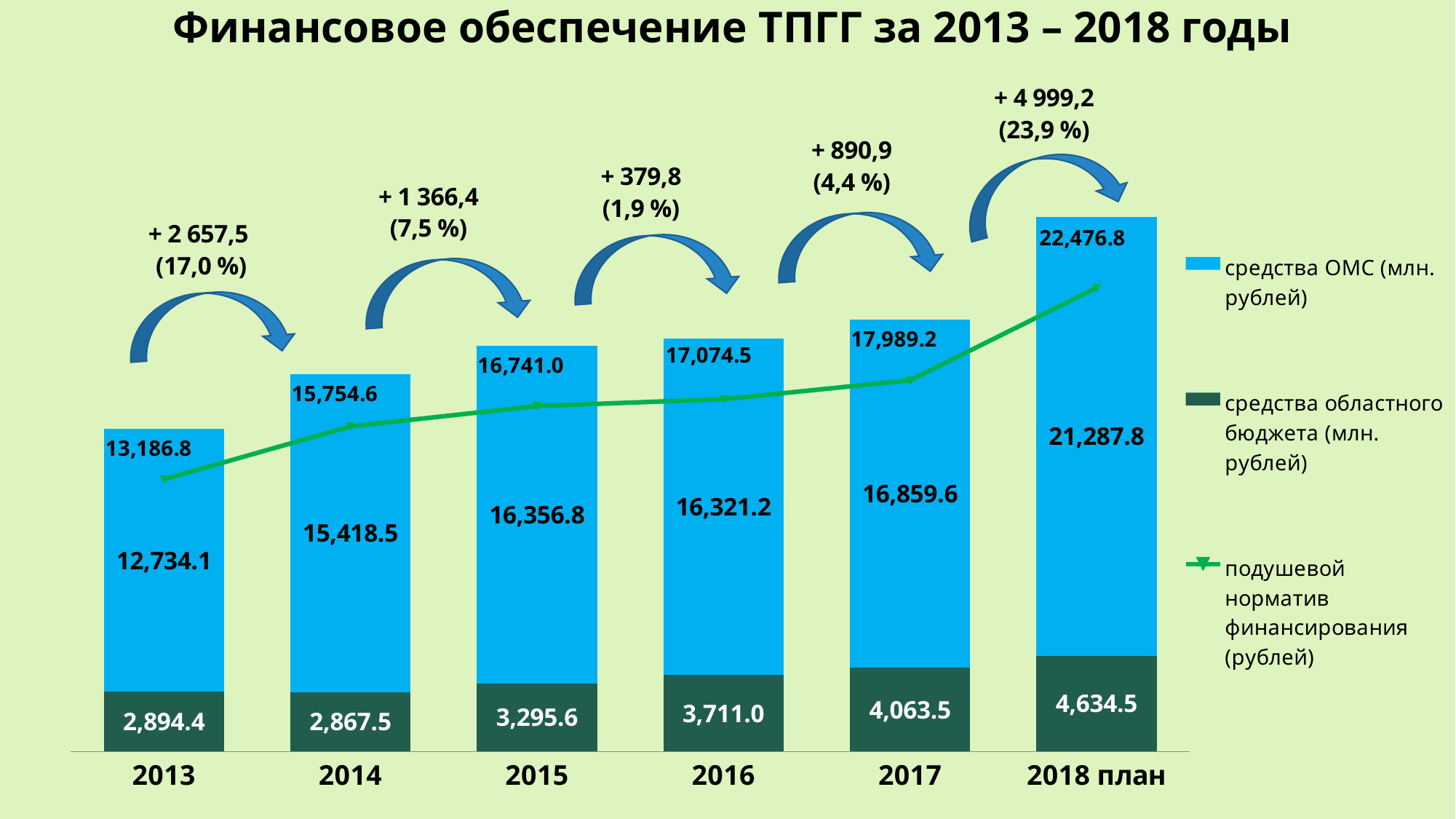
Does подушевой норматив финансирования (рублей) rise or fall from 2013 to 2018 план? Rise Which is larger: средства ОМС (млн. рублей) in 2015 or in 2016? 2015 What is the total of the stacked bar for 2013 (средства ОМС plus средства областного бюджета)? 15,628.5 How many years are shown on the x axis? 6 What is the difference between средства ОМС (млн. рублей) in 2018 план and in 2017? 4,428.2 What is the value of средства областного бюджета (млн. рублей) for 2015? 3,295.6 What is the value of средства ОМС (млн. рублей) for 2016? 16,321.2 Which year has the highest value of средства ОМС (млн. рублей)? 2018 план Which year has the lowest value of средства областного бюджета (млн. рублей)? 2014 What kind of chart is shown on the slide? Stacked bar chart with a line What is the value of подушевой норматив финансирования (рублей) for 2017? 17,989.2 How many series does the legend list? 3